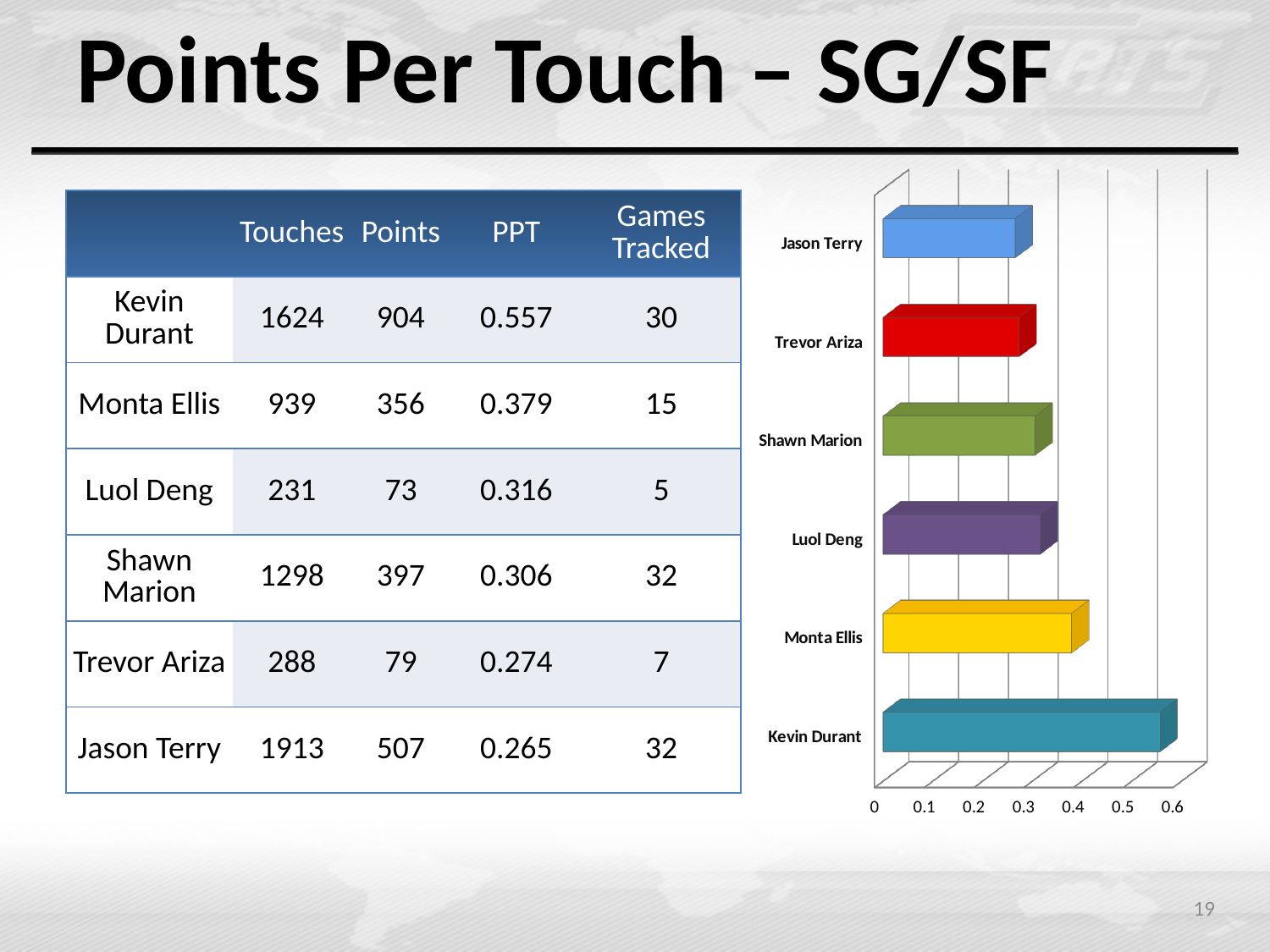
What colour is the bar for Trevor Ariza in the chart? red In the chart, which bar is longer: Monta Ellis or Jason Terry? Monta Ellis Is the value for Shawn Marion in the chart greater or less than 0.4? less What is the highest value shown on the chart's horizontal axis? 0.6 Is the value for Jason Terry in the chart greater or less than 0.3? less Is the value for Kevin Durant in the chart greater or less than 0.5? greater In the chart, which bar is longer: Kevin Durant or Monta Ellis? Kevin Durant Which player has the longest bar in the chart? Kevin Durant How many players are plotted in the bar chart? 6 What kind of chart is shown on the right of the slide? bar chart